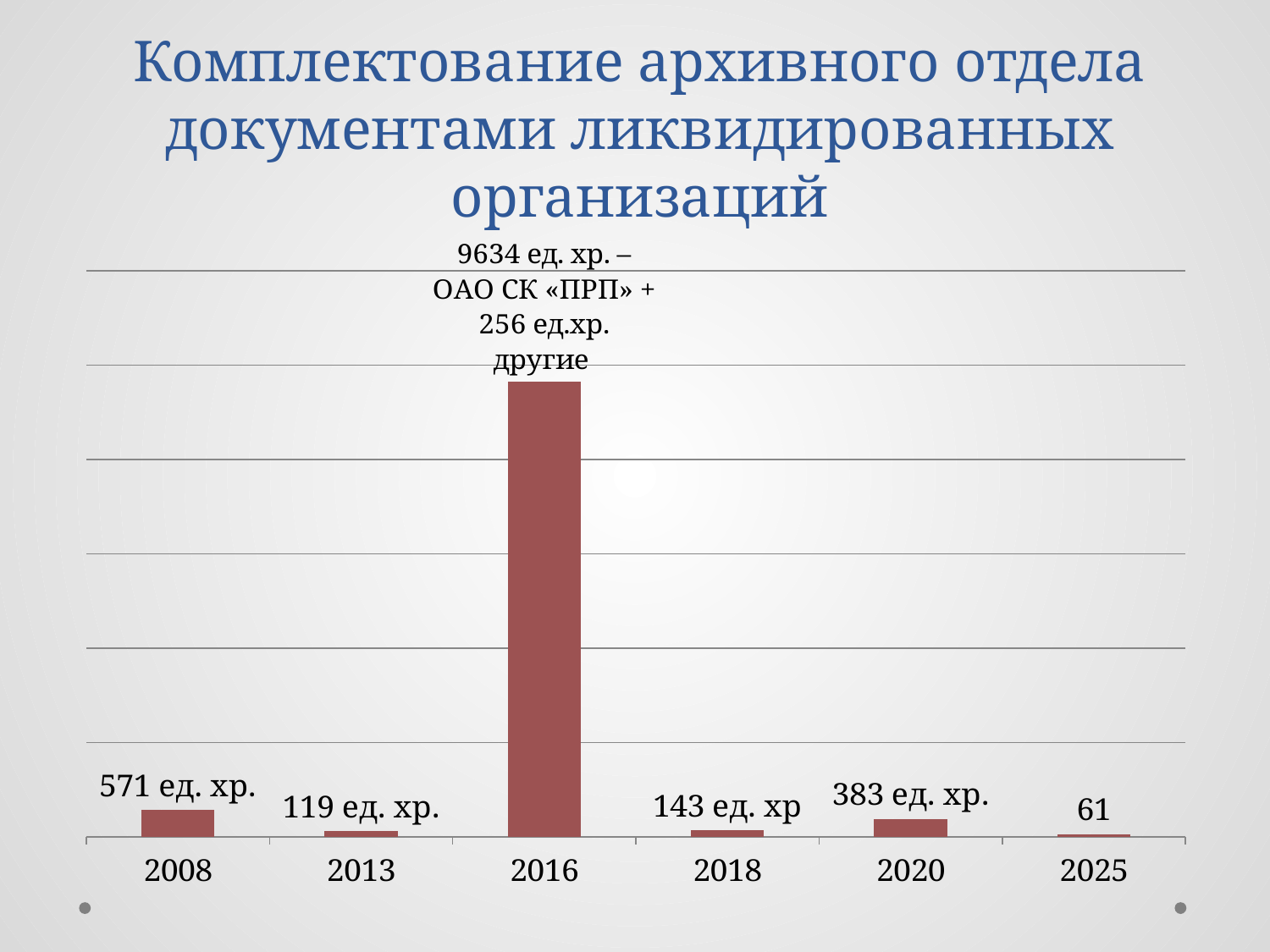
Which year has the highest bar? 2016 Which is larger, the value for 2008 or the value for 2020? 2008 What is the value shown for 2020? 383 ед. хр. What is the value shown for 2025? 61 What kind of chart is shown on the slide? Bar chart What is the value shown for 2008? 571 ед. хр. What is the value shown for 2013? 119 ед. хр. What is the value shown for 2018? 143 ед. хр How many years are shown on the x axis? 6 Which year has the lowest bar? 2025 What is the difference between the values for 2020 and 2018? 240 What is the difference between the values for 2008 and 2013? 452